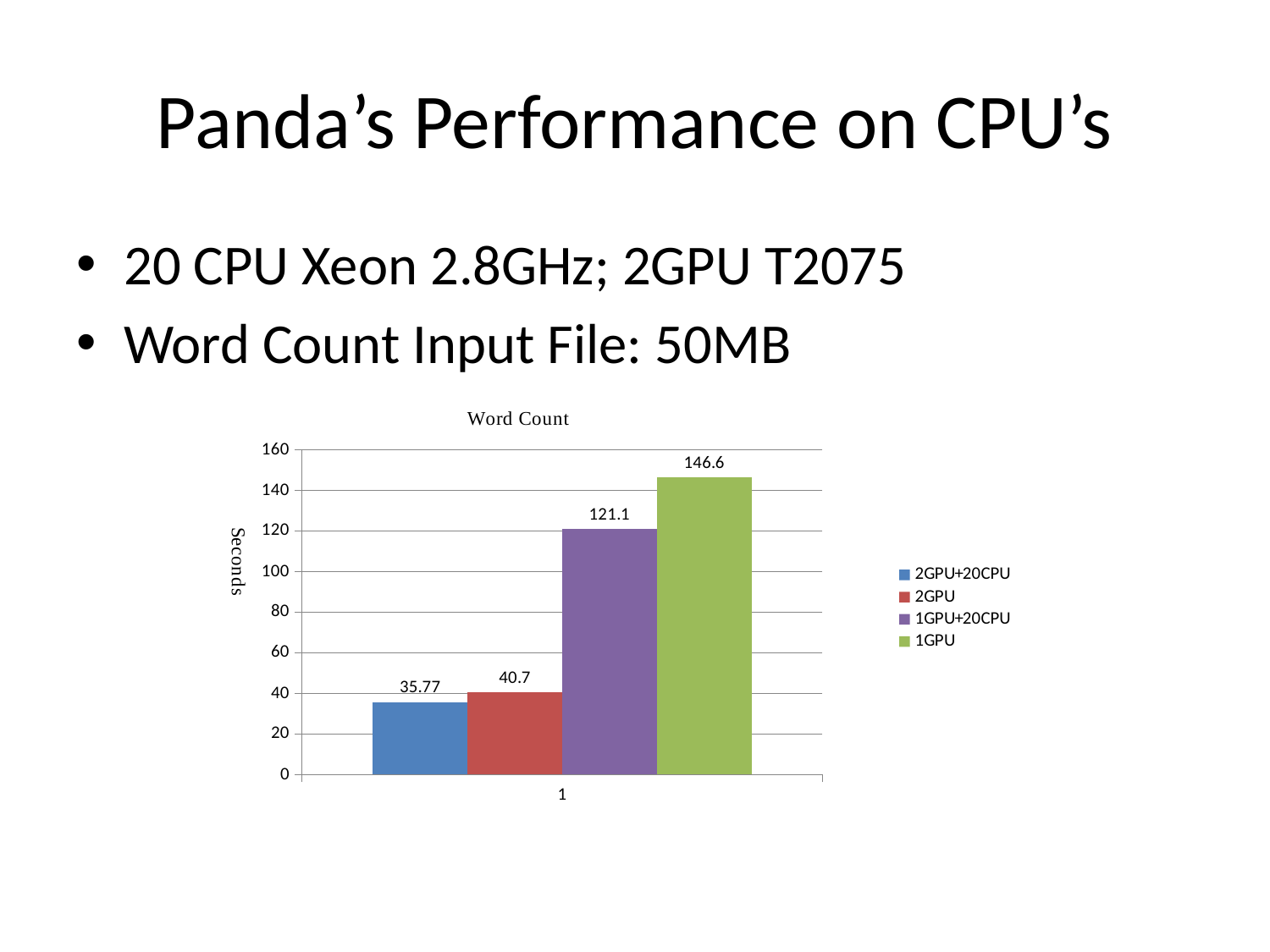
What is the label on the vertical axis of the Word Count chart? Seconds What is the value for the 2GPU+20CPU series in the Word Count chart? 35.77 How many series does the legend list in the Word Count chart? 4 Which is larger in the Word Count chart, the value for 2GPU or the value for 1GPU+20CPU? 1GPU+20CPU What is the value for the 1GPU series in the Word Count chart? 146.6 What is the value for the 1GPU+20CPU series in the Word Count chart? 121.1 Which series has the lowest value in the Word Count chart? 2GPU+20CPU What is the difference between the 2GPU and 2GPU+20CPU values in the Word Count chart? 4.93 What is the difference between the 1GPU and 1GPU+20CPU values in the Word Count chart? 25.5 Is the value for 1GPU+20CPU greater or less than 100 in the Word Count chart? greater What kind of chart is the Word Count chart? bar chart Which series has the highest value in the Word Count chart? 1GPU